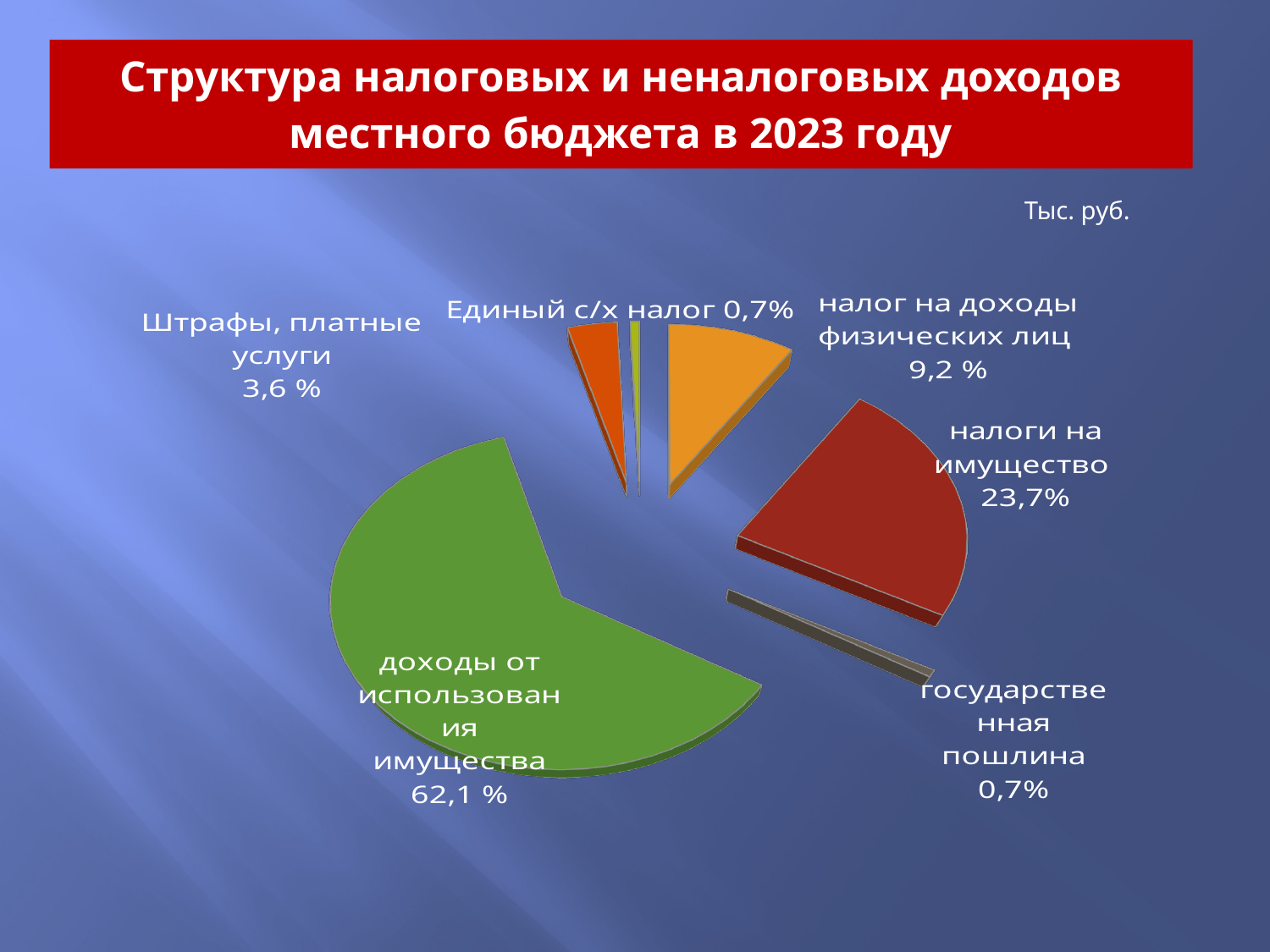
By how many percentage points does "доходы от использования имущества" exceed "налоги на имущество"? 38,4 What is the title of the slide containing the pie chart? Структура налоговых и неналоговых доходов местного бюджета в 2023 году What share is shown for "Единый с/х налог"? 0,7% What share is shown for "государственная пошлина"? 0,7% How many slices does the pie chart have? 6 What share is shown for "налоги на имущество"? 23,7% What share of the pie is labelled for "доходы от использования имущества"? 62,1 % What share is shown for "налог на доходы физических лиц"? 9,2 % Which category has the largest slice of the pie? доходы от использования имущества What kind of chart is shown on the slide? Pie chart Which is larger: the share for "налоги на имущество" or the share for "налог на доходы физических лиц"? налоги на имущество What share is shown for "Штрафы, платные услуги"? 3,6 %